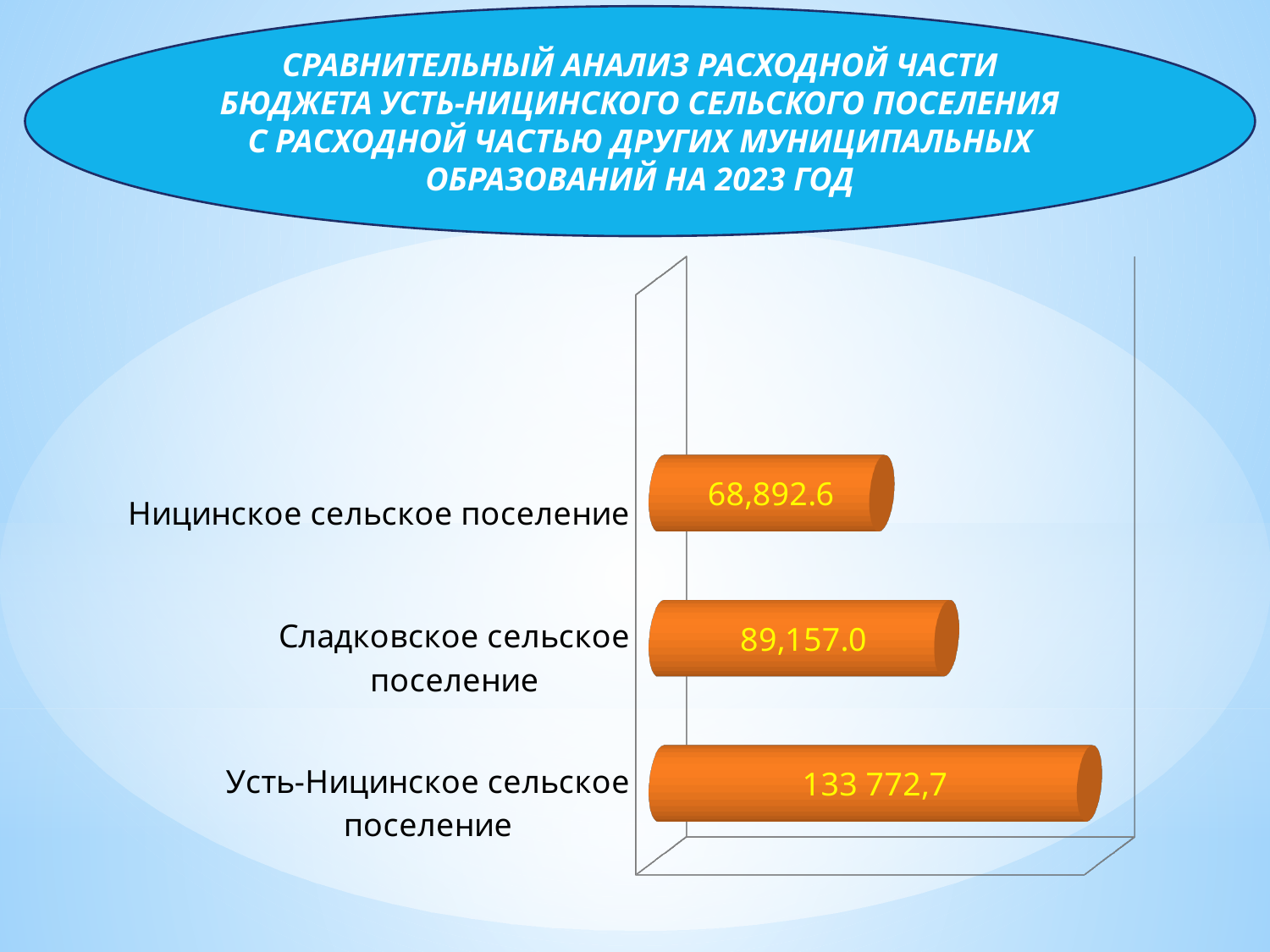
Do the bar values increase or decrease going from the top bar to the bottom bar? Increase What colour are the bars on the chart? Orange What is the value shown for Ницинское сельское поселение? 68,892.6 Which is larger: the value for Усть-Ницинское сельское поселение or for Сладковское сельское поселение? Усть-Ницинское сельское поселение Which settlement has the lowest value on the chart? Ницинское сельское поселение What is the value shown for Сладковское сельское поселение? 89,157.0 Which settlement has the highest value on the chart? Усть-Ницинское сельское поселение What kind of chart is shown on the slide? Bar chart What is the value shown for Усть-Ницинское сельское поселение? 133 772,7 How many settlements are shown on the chart? 3 What is the difference between the values for Сладковское сельское поселение and Ницинское сельское поселение? 20,264.4 Which is larger: the value for Сладковское сельское поселение or for Ницинское сельское поселение? Сладковское сельское поселение